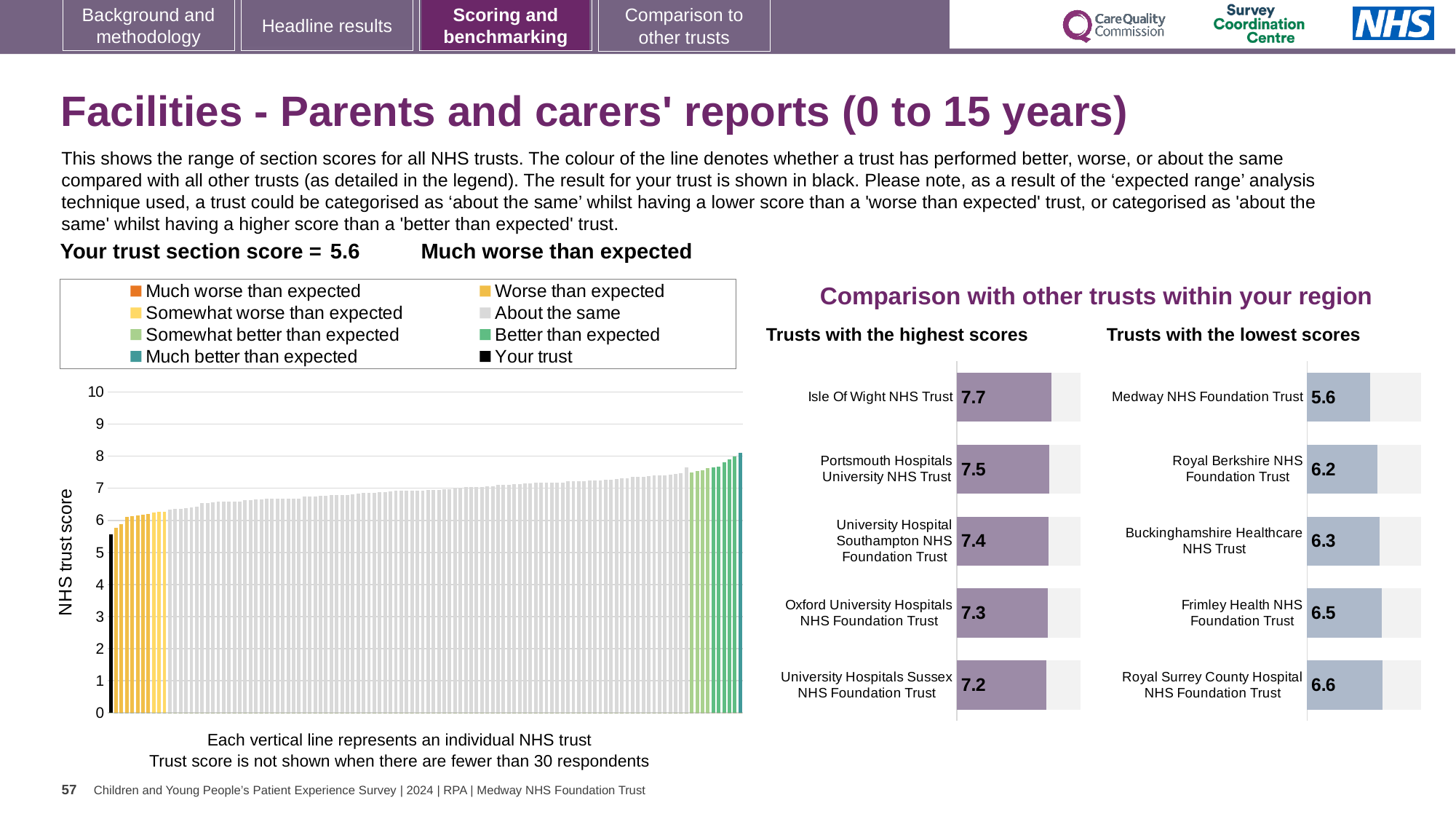
In the large chart on the left, is the value for the black 'Your trust' bar greater or less than 6? less In the large chart on the left, do the trust scores rise or fall from left to right? rise In the 'Trusts with the lowest scores' chart, which trust has the lowest score? Medway NHS Foundation Trust In the 'Trusts with the highest scores' chart, what is the score for University Hospitals Sussex NHS Foundation Trust? 7.2 In the 'Trusts with the highest scores' chart, what is the score for Isle Of Wight NHS Trust? 7.7 In the 'Trusts with the highest scores' chart, what is the difference between the scores of Isle Of Wight NHS Trust and University Hospitals Sussex NHS Foundation Trust? 0.5 In the 'Trusts with the lowest scores' chart, what is the difference between the scores of Royal Surrey County Hospital NHS Foundation Trust and Medway NHS Foundation Trust? 1.0 In the 'Trusts with the highest scores' chart, which trust has the highest score? Isle Of Wight NHS Trust How many trusts are shown in the 'Trusts with the lowest scores' chart? 5 In the 'Trusts with the lowest scores' chart, which has the higher score: Frimley Health NHS Foundation Trust or Buckinghamshire Healthcare NHS Trust? Frimley Health NHS Foundation Trust In the 'Trusts with the lowest scores' chart, what is the score for Royal Berkshire NHS Foundation Trust? 6.2 How many entries does the legend of the large chart on the left list? 8